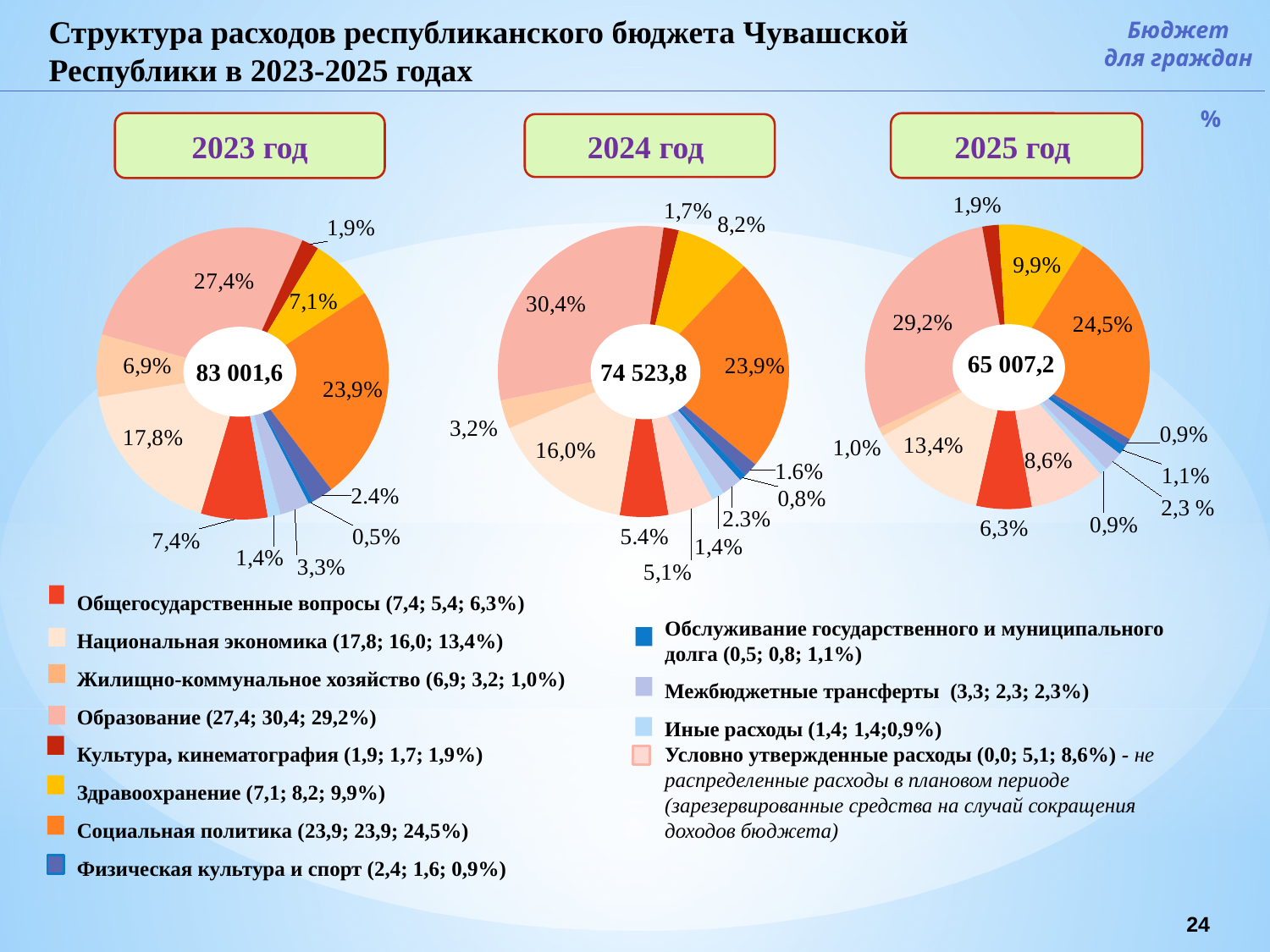
On the 2023 год chart, which category has the largest slice? Образование By how many percentage points does the share of Образование in 2024 exceed its share in 2023? 3,0 On the 2023 год chart, which category has the smallest slice? Обслуживание государственного и муниципального долга Does the share of Здравоохранение rise or fall from 2023 to 2025? Rises What kind of chart is used to show the budget structure for each year? Pie chart How many pie charts are shown on the slide? 3 On the 2025 год chart, which is larger: Здравоохранение or Общегосударственные вопросы? Здравоохранение What total value is printed in the centre of the 2024 год chart? 74 523,8 How many expenditure categories does the legend list? 12 On the 2025 год chart, what share is shown for Социальная политика? 24,5% On the 2023 год chart, what share is shown for Образование? 27,4% On the 2024 год chart, what share is shown for Образование? 30,4%